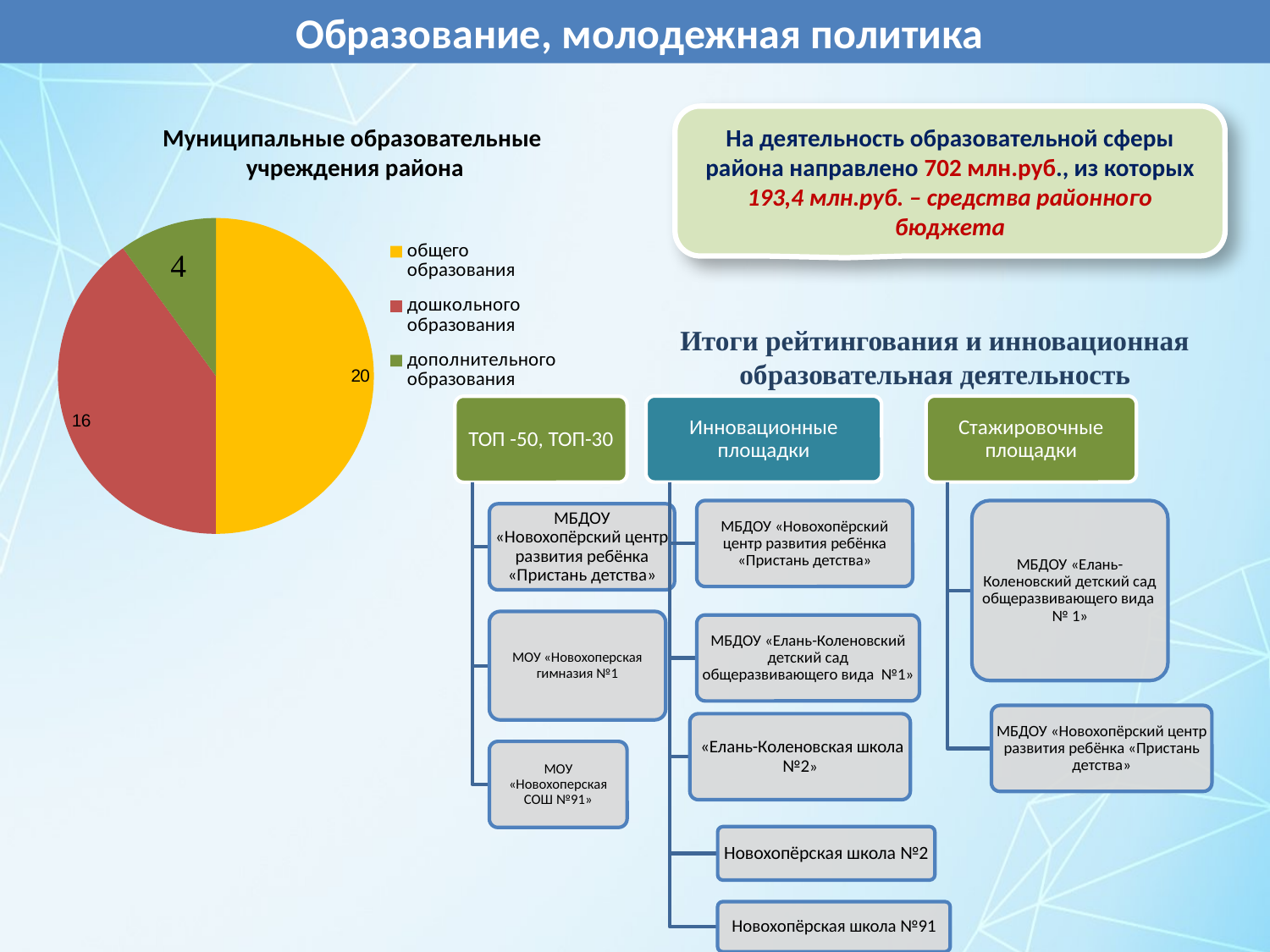
What is the difference between the values for "общего образования" and "дошкольного образования" in the pie chart? 4 Which category has the largest slice in the pie chart? общего образования What type of chart is shown under the title "Муниципальные образовательные учреждения района"? pie chart How many categories does the pie chart show? 3 Which category has the smallest slice in the pie chart? дополнительного образования What share of the pie chart does "общего образования" represent? 50% In the pie chart, what is the value for "общего образования"? 20 What colour is the "дошкольного образования" slice in the pie chart? red What is the total of all slices in the pie chart? 40 In the pie chart, what is the value for "дошкольного образования"? 16 Which is larger in the pie chart: "дошкольного образования" or "дополнительного образования"? дошкольного образования In the pie chart, what is the value for "дополнительного образования"? 4